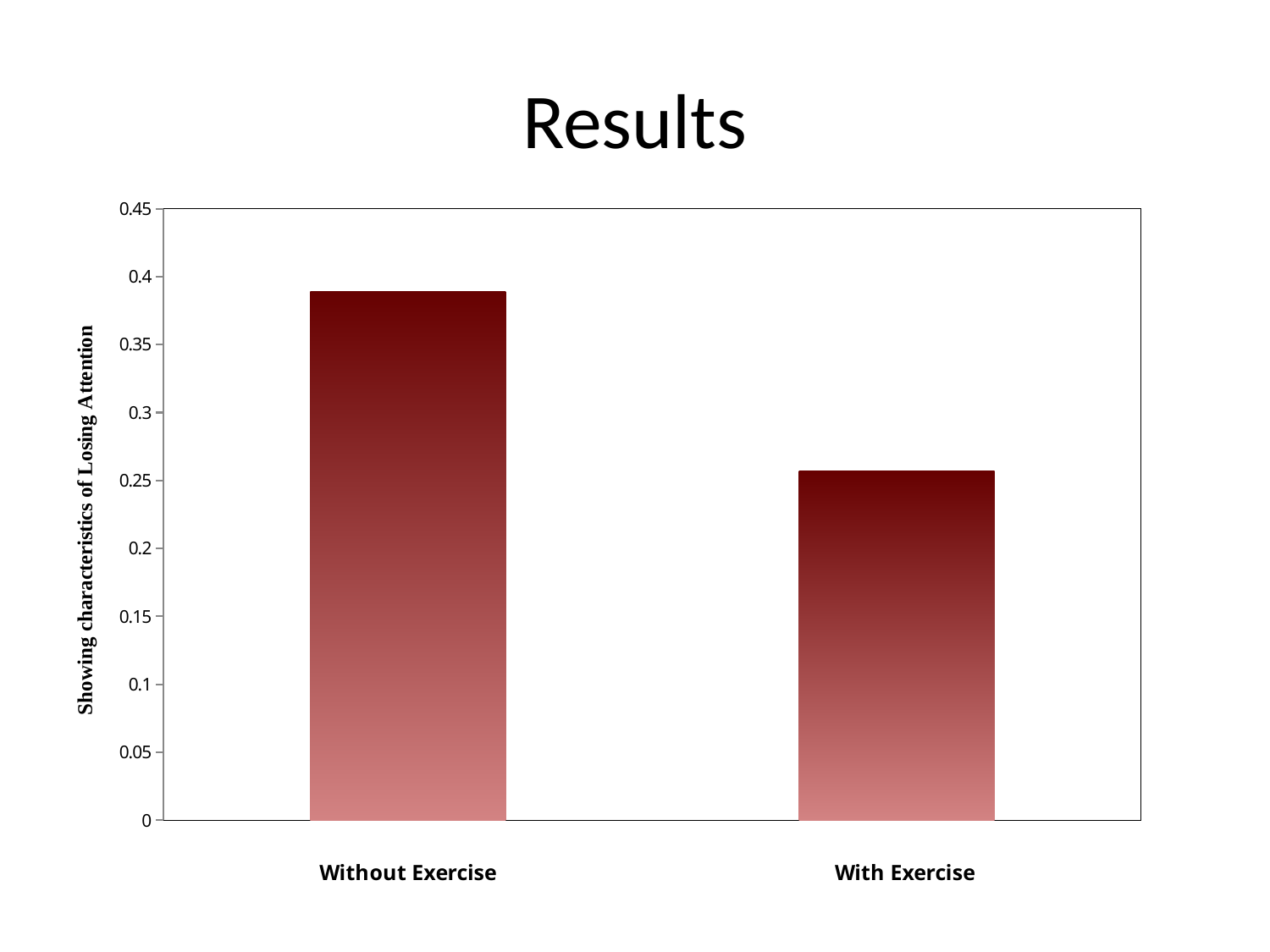
Which category has the highest bar? Without Exercise Do the values rise or fall from Without Exercise to With Exercise? fall Is the value for Without Exercise greater or less than 0.4? less How many categories are plotted on the chart? 2 Which category has the lowest bar? With Exercise Is the value for Without Exercise greater or less than 0.35? greater Is the value for With Exercise greater or less than 0.2? greater What is the label on the vertical axis of the chart? Showing characteristics of Losing Attention What is the title of the slide? Results Which is larger, the value for Without Exercise or the value for With Exercise? Without Exercise What kind of chart is shown on the slide? bar chart